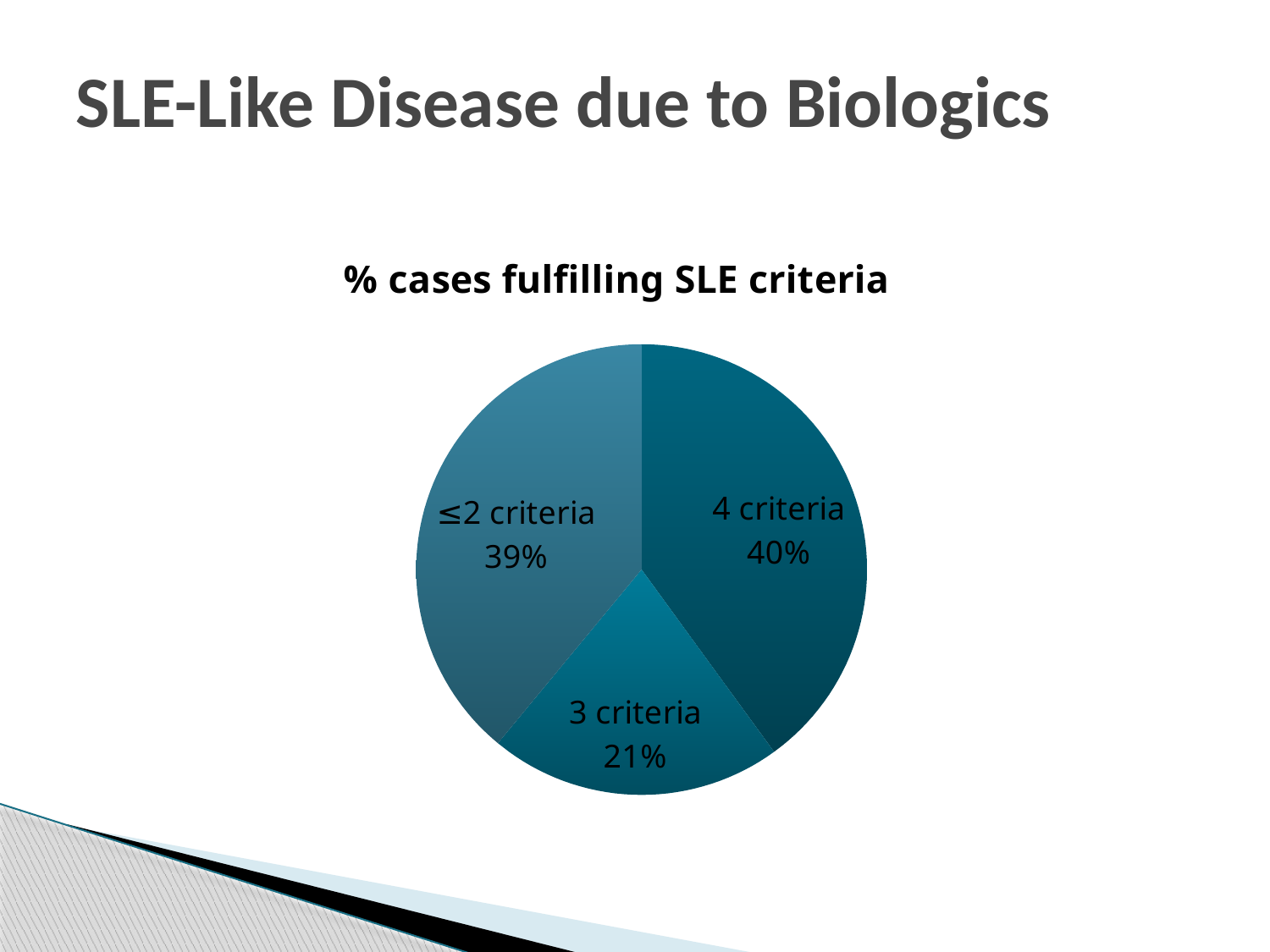
What percentage of cases fulfilled 3 criteria? 21% Which category has the largest share of the pie? 4 criteria What percentage of cases fulfilled 4 criteria? 40% Which is larger: the share for 3 criteria or the share for ≤2 criteria? ≤2 criteria What percentage of cases fulfilled ≤2 criteria? 39% What is the title of the chart? % cases fulfilling SLE criteria How many slices does the pie chart have? 3 What is the difference in percentage points between the 4 criteria slice and the 3 criteria slice? 19 What is the difference in percentage points between the ≤2 criteria slice and the 3 criteria slice? 18 Which category has the smallest share of the pie? 3 criteria What kind of chart is shown on the slide? Pie chart What is the combined share of the 4 criteria and 3 criteria slices? 61%